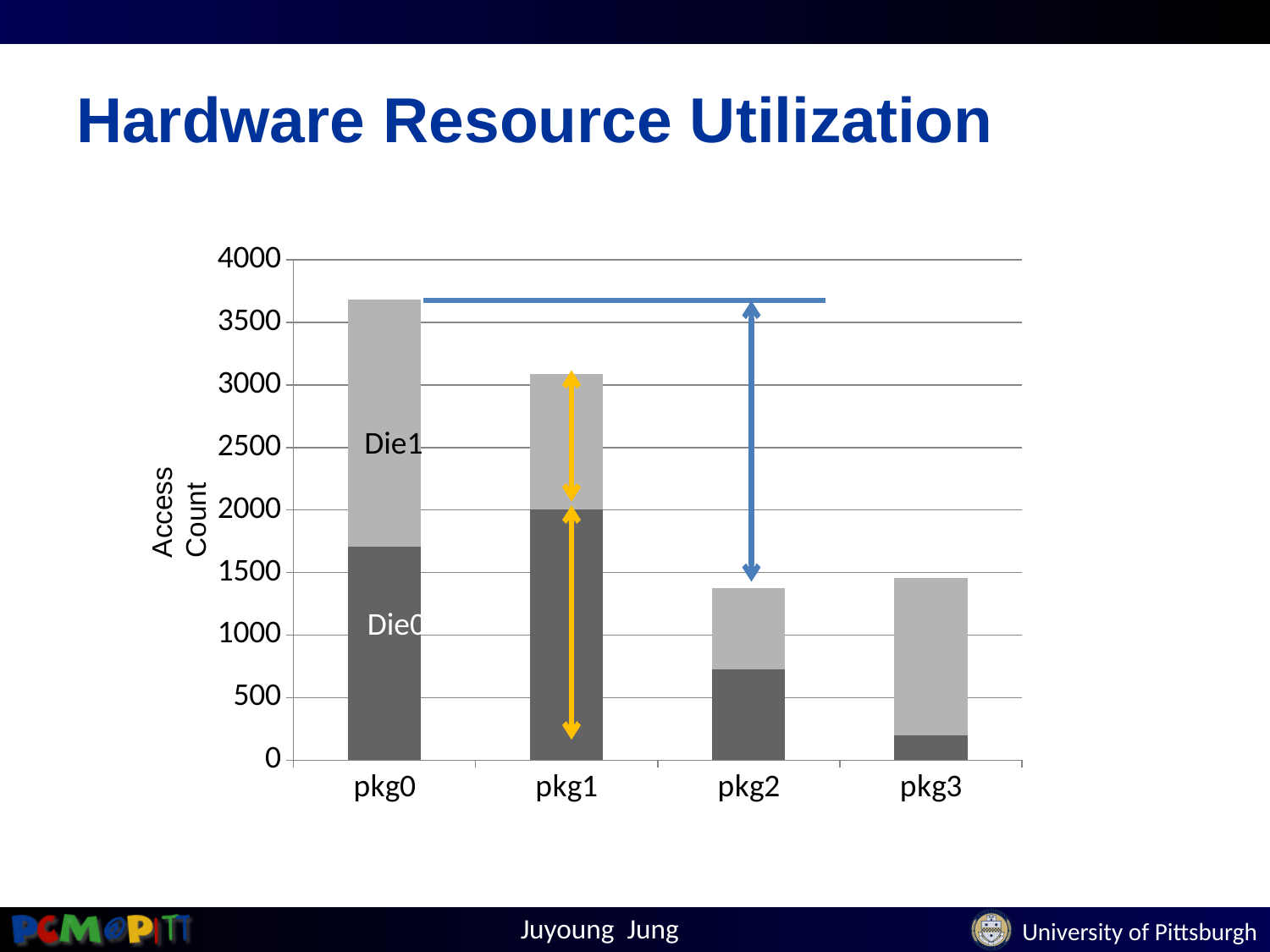
What kind of chart is shown on the slide? stacked bar chart Which package has the highest Die0 access count? pkg1 Is the Die0 access count for pkg0 greater or less than 1500? greater Is the total access count for pkg0 greater or less than 3500? greater Which has the larger total access count, pkg0 or pkg1? pkg0 Is the Die0 access count for pkg3 greater or less than 500? less What is the label on the vertical axis of the chart? Access Count Which package has the lowest Die0 access count? pkg3 How many packages (categories) are shown on the x axis? 4 Which package has the highest total access count? pkg0 Which has the larger total access count, pkg1 or pkg2? pkg1